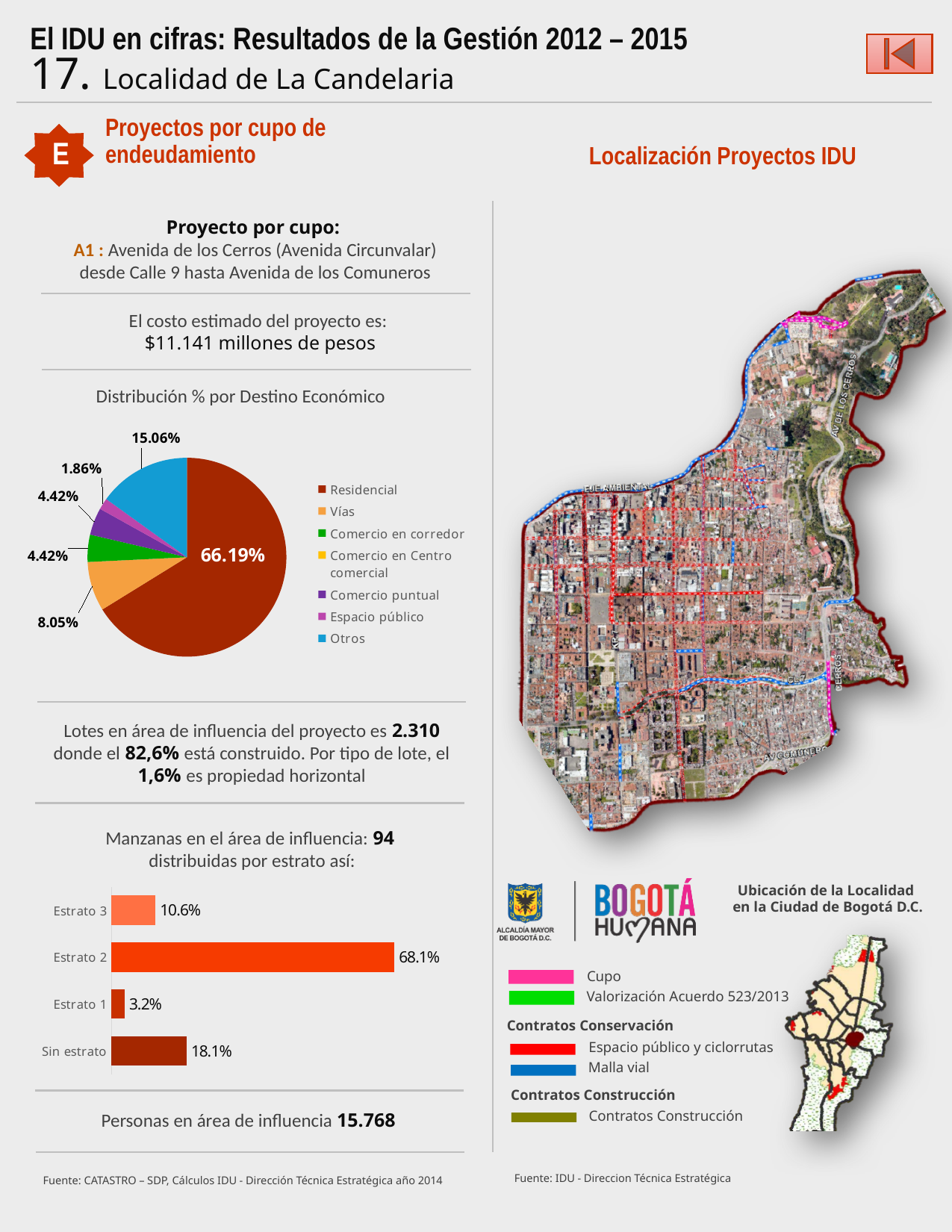
In the pie chart 'Distribución % por Destino Económico', what share is Vías? 8.05% What type of chart is 'Distribución % por Destino Económico'? Pie chart In the pie chart 'Distribución % por Destino Económico', how many entries does the legend list? 7 In the pie chart 'Distribución % por Destino Económico', what share is Otros? 15.06% In the bar chart of Manzanas by estrato, which is larger: Estrato 3 or Sin estrato? Sin estrato In the bar chart of Manzanas by estrato, what is the value for Estrato 2? 68.1% In the pie chart 'Distribución % por Destino Económico', what is the difference between the Residencial and Otros shares? 51.13% In the pie chart 'Distribución % por Destino Económico', which category has the largest slice? Residencial In the bar chart of Manzanas by estrato, how many categories are shown? 4 In the bar chart of Manzanas by estrato, what is the value for Sin estrato? 18.1% In the bar chart of Manzanas by estrato, which category has the lowest value? Estrato 1 In the pie chart 'Distribución % por Destino Económico', what share is Residencial? 66.19%